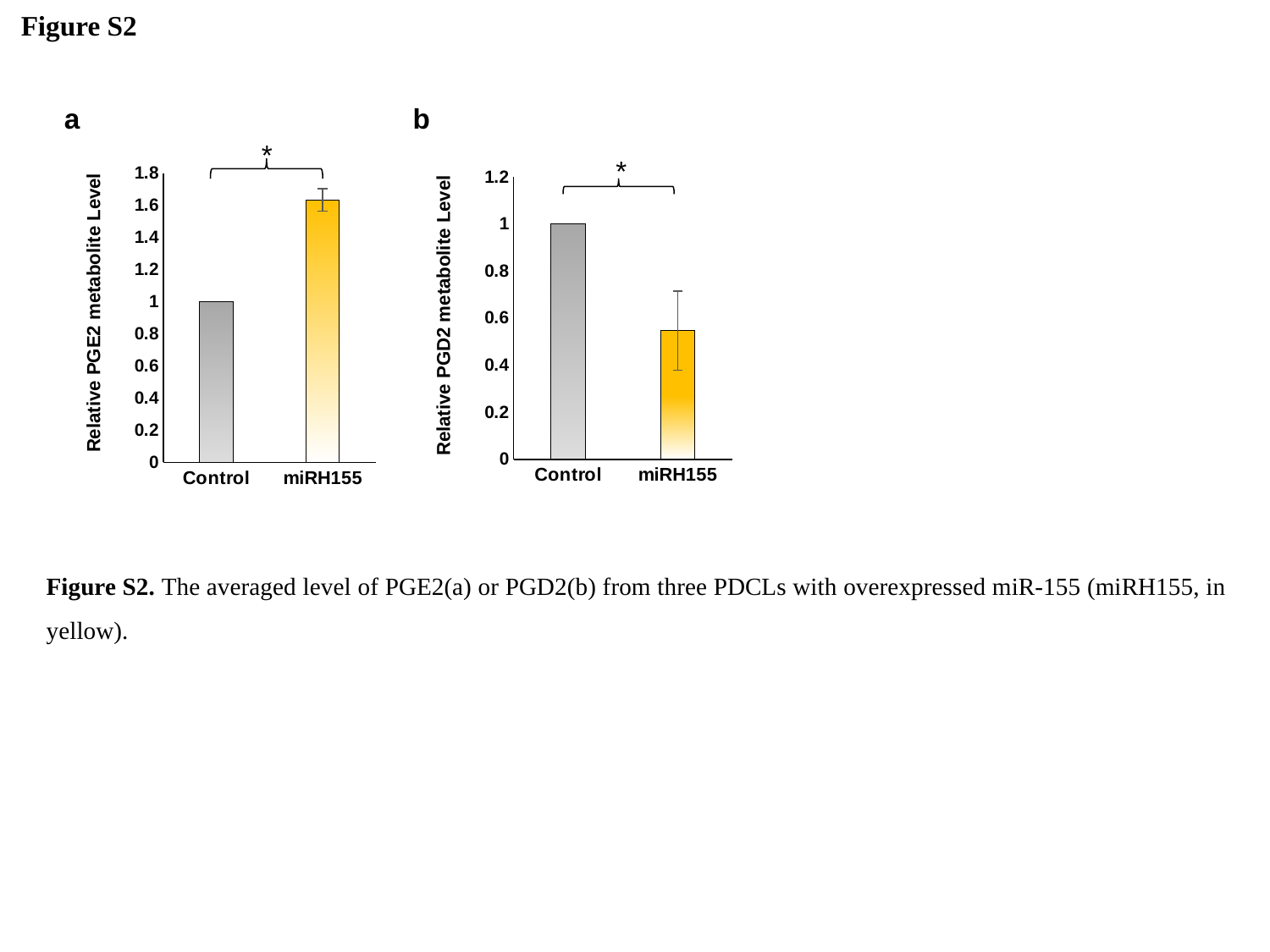
In chart a (Relative PGE2 metabolite Level), which category has the highest value? miRH155 What is the y-axis title of chart a, the left chart? Relative PGE2 metabolite Level What kind of chart is chart b (Relative PGD2 metabolite Level)? bar chart In chart b (Relative PGD2 metabolite Level), which category has the lowest value? miRH155 In chart b (Relative PGD2 metabolite Level), which is larger, Control or miRH155? Control In chart b (Relative PGD2 metabolite Level), what is the value for Control? 1 How many categories are shown in chart a (Relative PGE2 metabolite Level)? 2 In chart a (Relative PGE2 metabolite Level), what is the value for Control? 1 In chart b (Relative PGD2 metabolite Level), is the value for miRH155 greater or less than 0.4? greater In chart a (Relative PGE2 metabolite Level), is the value for miRH155 greater or less than 1.4? greater In chart a (Relative PGE2 metabolite Level), which is larger, Control or miRH155? miRH155 In chart b (Relative PGD2 metabolite Level), is the value for miRH155 greater or less than 0.8? less